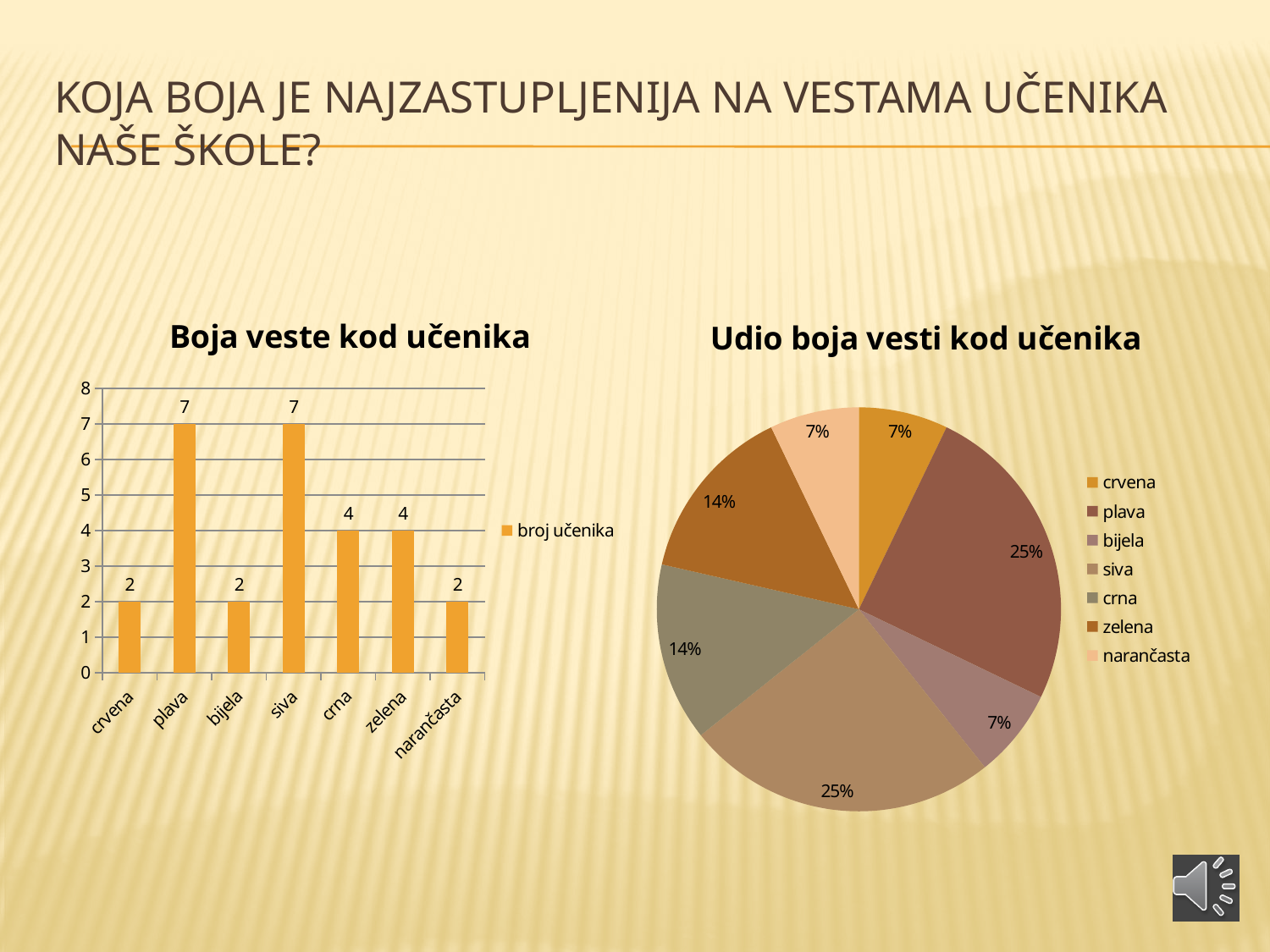
In the pie chart 'Udio boja vesti kod učenika', what share does crna have? 14% What is the title of the chart on the right of the slide? Udio boja vesti kod učenika In the pie chart 'Udio boja vesti kod učenika', how many slices are there? 7 What kind of chart is the chart on the left of the slide? bar chart In the bar chart 'Boja veste kod učenika', what is the value for plava? 7 In the bar chart 'Boja veste kod učenika', what is the difference between the values for plava and crna? 3 In the bar chart 'Boja veste kod učenika', which is larger, the value for siva or the value for zelena? siva In the bar chart 'Boja veste kod učenika', what is the value for narančasta? 2 In the bar chart 'Boja veste kod učenika', how many series does the legend list? 1 In the bar chart 'Boja veste kod učenika', how many categories are shown on the x axis? 7 In the bar chart 'Boja veste kod učenika', what is the value for crna? 4 In the pie chart 'Udio boja vesti kod učenika', what share does plava have? 25%